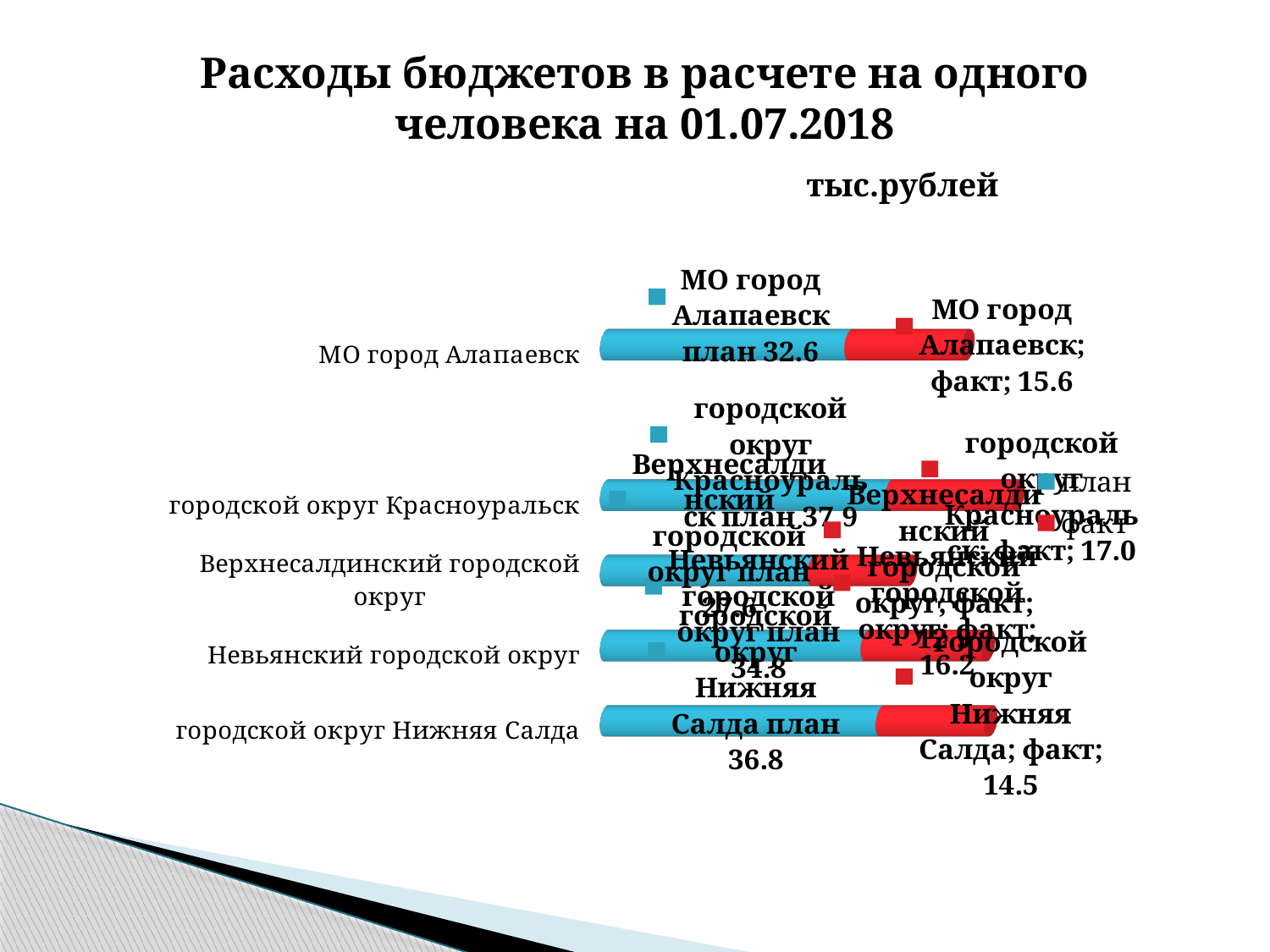
What is the план value for городской округ Нижняя Салда? 36.8 What is the факт (actual) value for МО город Алапаевск? 15.6 What kind of chart is shown on the slide? Stacked bar chart What is the факт value for городской округ Нижняя Салда? 14.5 How many series does the legend list? 2 What is the total of the stacked bar (план plus факт) for МО город Алапаевск? 48.2 What is the план (plan) value for МО город Алапаевск? 32.6 What is the план value for городской округ Красноуральск? 37.9 How many municipalities (categories) are shown in the chart? 5 By how much does the план value exceed the факт value for МО город Алапаевск? 17.0 What is the факт value for городской округ Красноуральск? 17.0 Which has the larger план value: городской округ Красноуральск or городской округ Нижняя Салда? городской округ Красноуральск